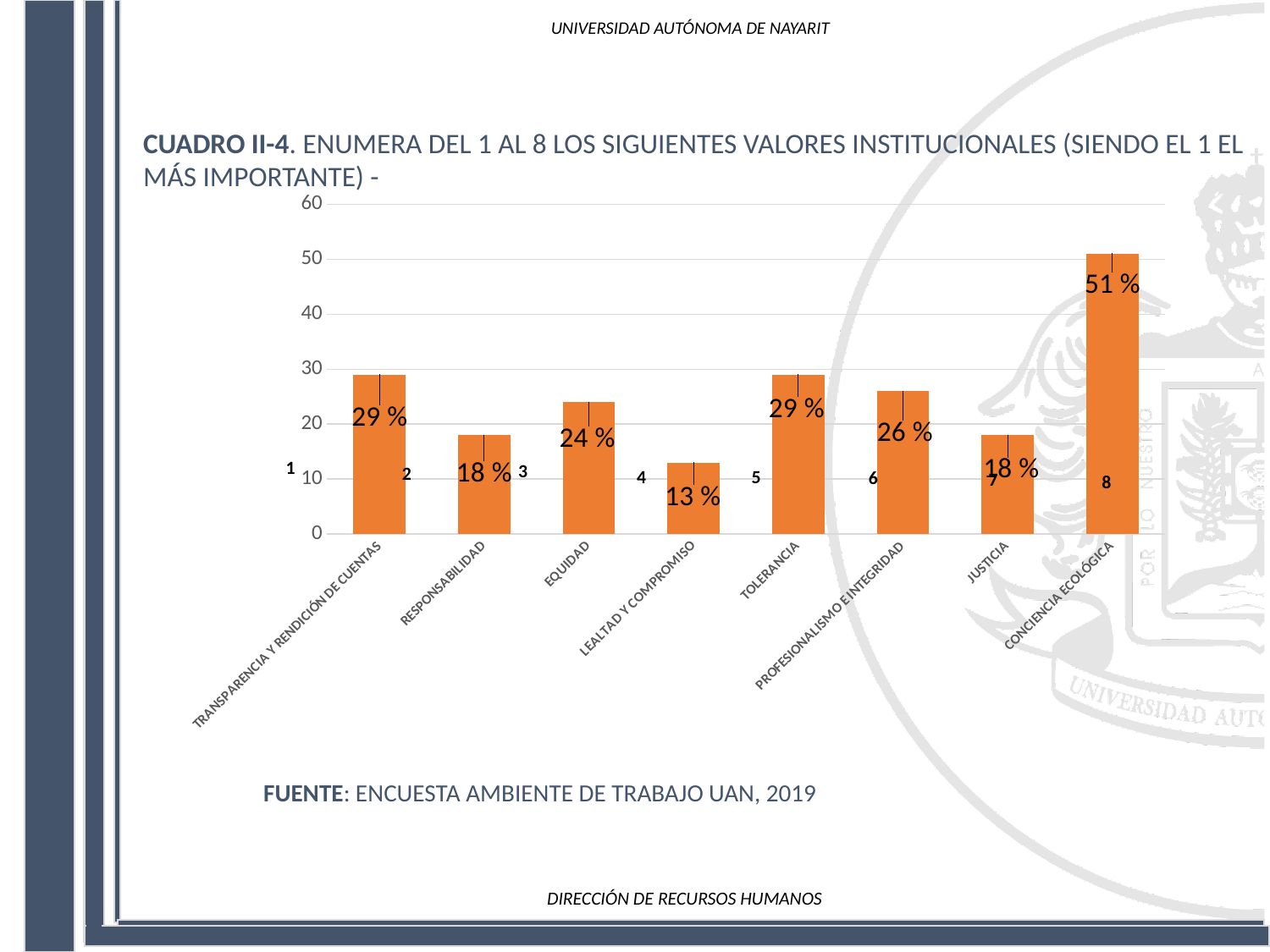
What is the value shown for EQUIDAD? 24 % How many categories (institutional values) are plotted in the chart? 8 Is the value for LEALTAD Y COMPROMISO greater or less than 20? less Which category has the highest value? CONCIENCIA ECOLÓGICA What is the difference between the values for CONCIENCIA ECOLÓGICA and LEALTAD Y COMPROMISO? 38 % What kind of chart is shown on the slide? bar chart What is the value shown for LEALTAD Y COMPROMISO? 13 % What is the value shown for PROFESIONALISMO E INTEGRIDAD? 26 % Which category has the lowest value? LEALTAD Y COMPROMISO What source is cited below the chart? ENCUESTA AMBIENTE DE TRABAJO UAN, 2019 What is the value shown for CONCIENCIA ECOLÓGICA? 51 % Which has a larger value, EQUIDAD or PROFESIONALISMO E INTEGRIDAD? PROFESIONALISMO E INTEGRIDAD